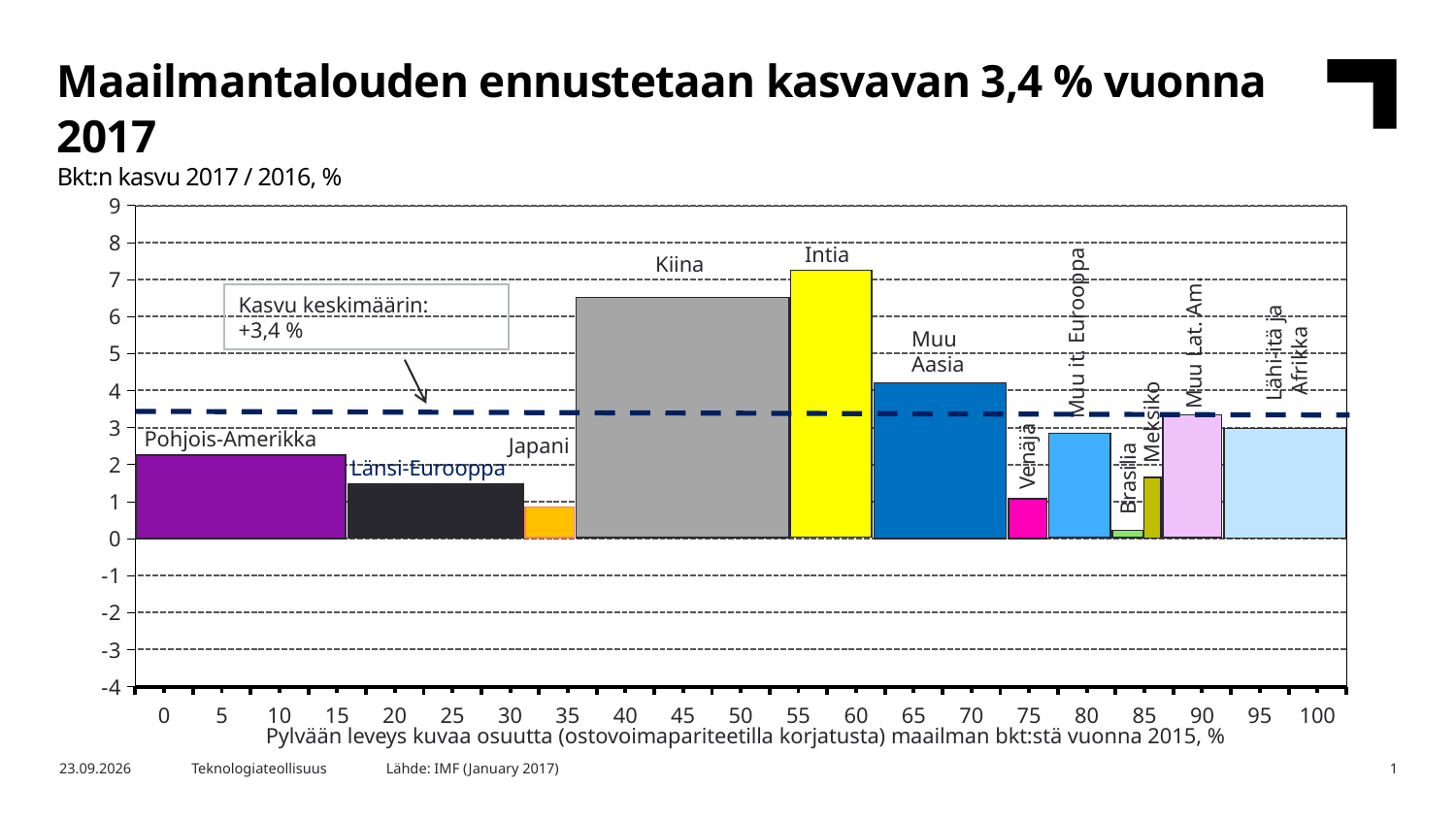
Which has the higher growth forecast, Länsi-Eurooppa or Pohjois-Amerikka? Pohjois-Amerikka Which region has the lowest GDP growth forecast in the chart? Brasilia What average growth value is indicated by the dashed line in the chart? +3,4 % Is the value for Pohjois-Amerikka greater or less than 2? greater Is the value for Muu Aasia greater or less than 4? greater Is the value for Kiina greater or less than 6? greater Which has the higher growth forecast, Kiina or Muu Aasia? Kiina Which region has the highest GDP growth forecast in the chart? Intia How many regions are shown as bars in the chart? 12 What kind of chart is shown on the slide? Bar chart